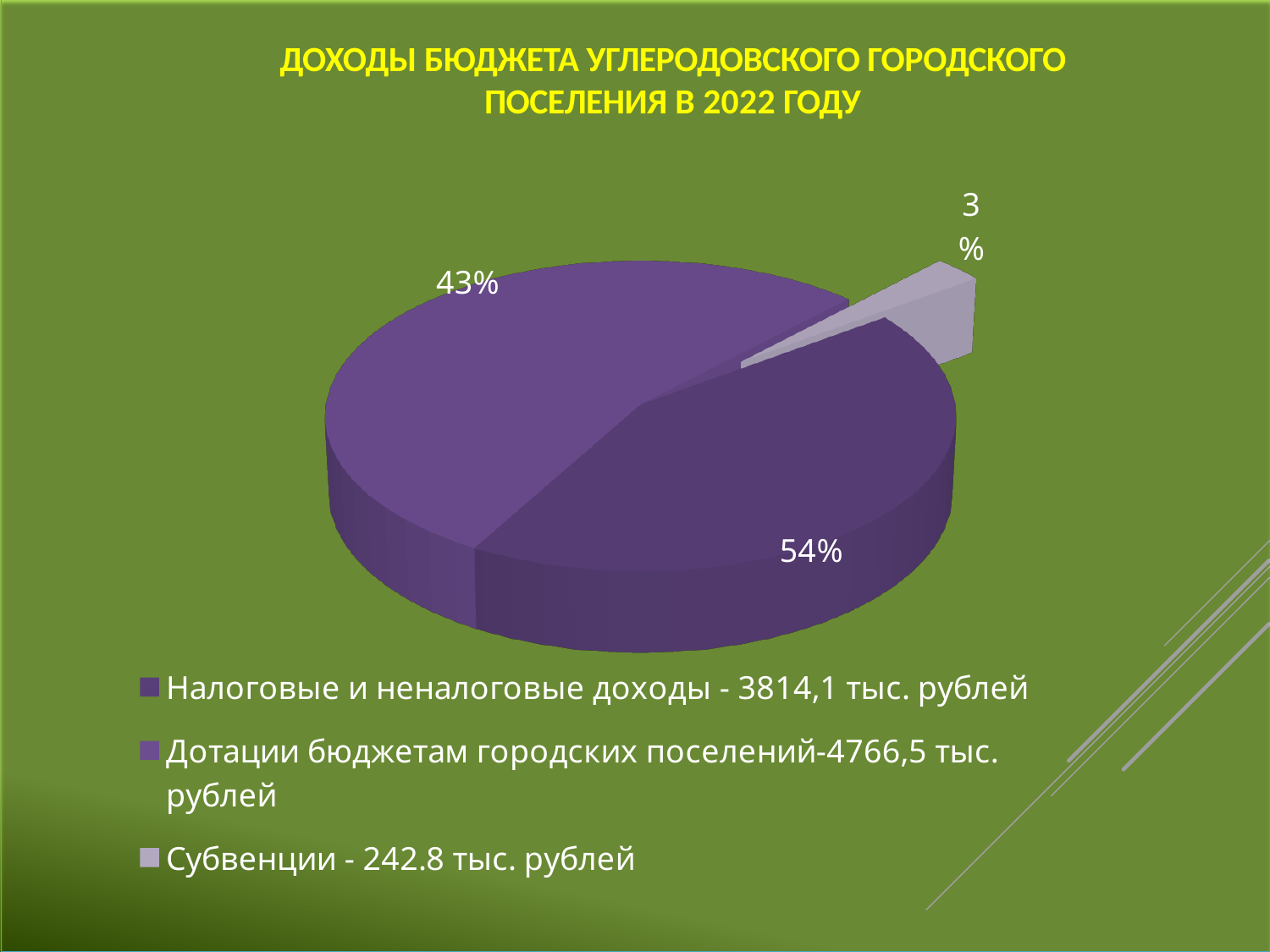
Which legend category has the largest amount in тыс. рублей? Дотации бюджетам городских поселений What is the difference between the 54% slice and the 43% slice? 11% What kind of chart is shown on the slide? pie chart What amount is given in the legend for Субвенции? 242.8 тыс. рублей What is the smallest share shown on the pie chart? 3% What is the largest share shown on the pie chart? 54% What is the title of the chart? ДОХОДЫ БЮДЖЕТА УГЛЕРОДОВСКОГО ГОРОДСКОГО ПОСЕЛЕНИЯ В 2022 ГОДУ What share of the pie does the Субвенции slice represent? 3% Which is larger: Налоговые и неналоговые доходы or Дотации бюджетам городских поселений? Дотации бюджетам городских поселений What amount is given in the legend for Налоговые и неналоговые доходы? 3814,1 тыс. рублей How many entries does the legend list? 3 How many slices does the pie chart have? 3